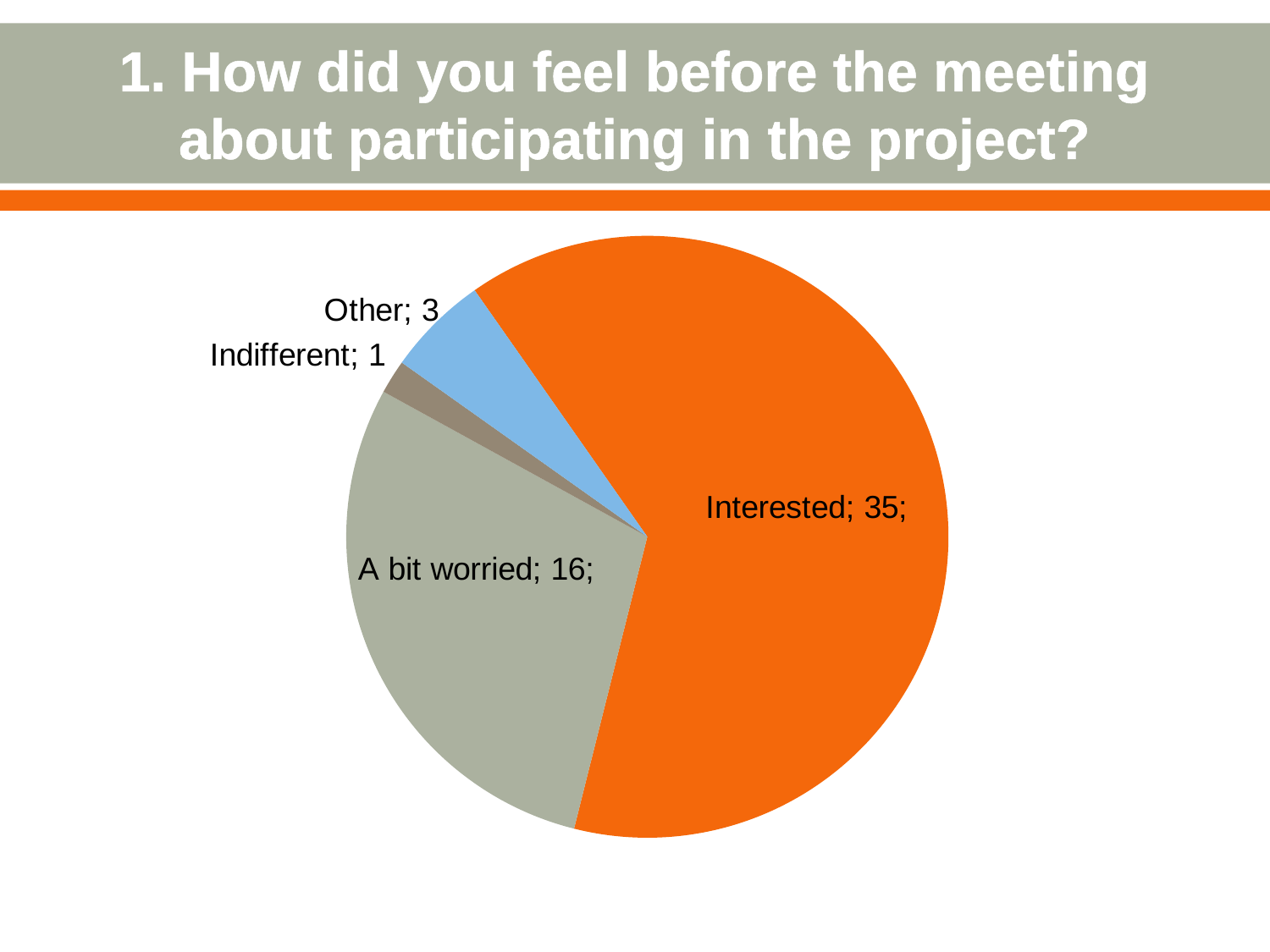
Which is larger, the 'Other' slice or the 'Indifferent' slice? Other Which category has the largest slice of the pie? Interested What is the value for the 'Indifferent' slice? 1 What kind of chart is shown on the slide? pie chart What is the value for the 'A bit worried' slice? 16 What is the title of the slide containing the pie chart? 1. How did you feel before the meeting about participating in the project? Which category has the smallest slice of the pie? Indifferent What is the total of all the slice values in the pie chart? 55 How many categories are shown in the pie chart? 4 What is the value for the 'Other' slice? 3 How many respondents said they were Interested? 35 What is the difference between the 'Interested' and 'A bit worried' values? 19